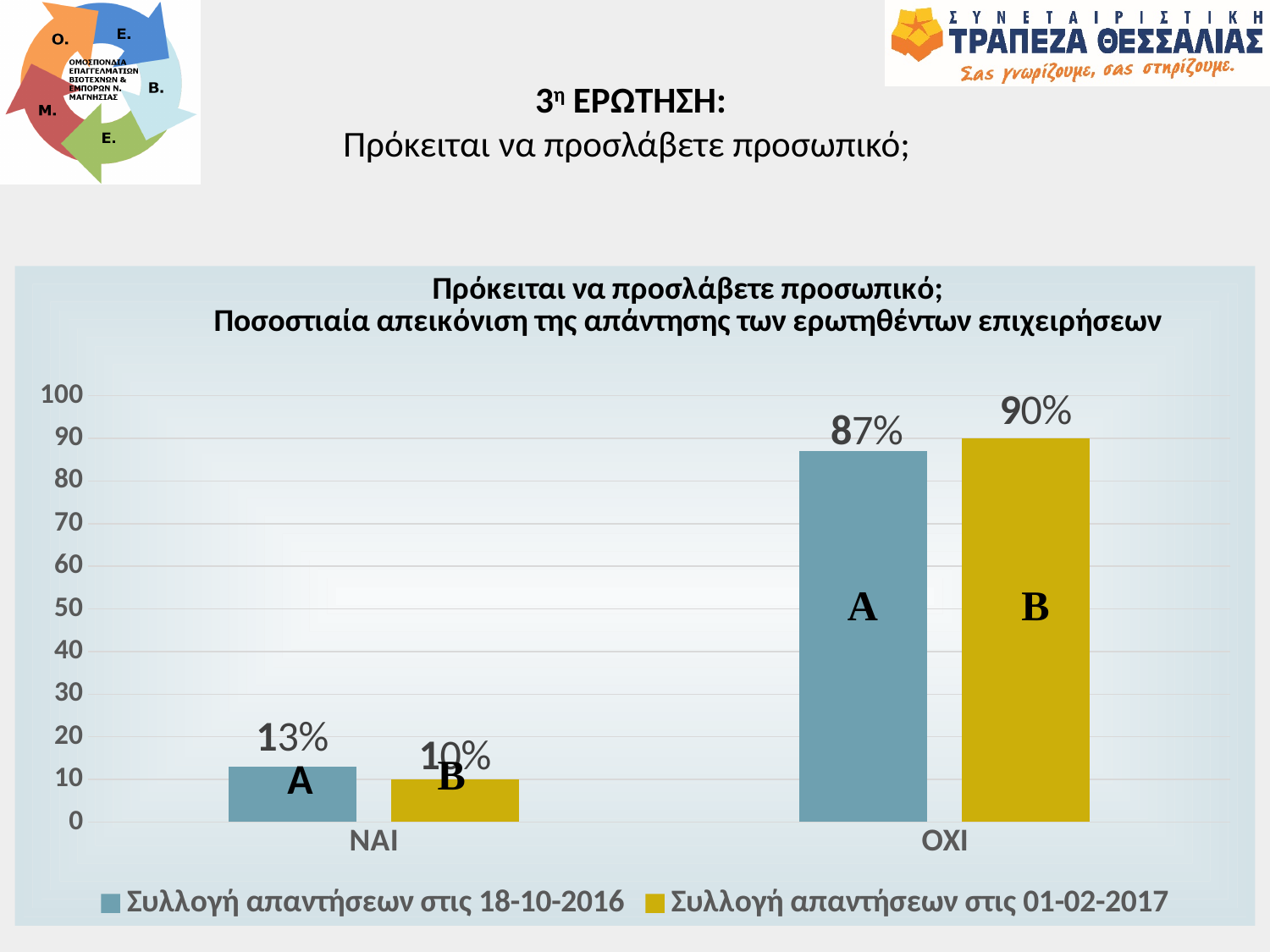
For ΝΑΙ, which series has the larger value: 18-10-2016 or 01-02-2017? 18-10-2016 Which category has the highest value in the 01-02-2017 series? ΟΧΙ How many categories are shown on the x axis? 2 What percentage of businesses answered ΟΧΙ in the 01-02-2017 collection (Συλλογή απαντήσεων στις 01-02-2017)? 90% What colour are the bars for the 01-02-2017 series (Συλλογή απαντήσεων στις 01-02-2017)? Yellow What is the value for ΝΑΙ in the 01-02-2017 series? 10% How many series does the legend list? 2 What is the value for ΟΧΙ in the 18-10-2016 series? 87% What is the difference between the ΟΧΙ values of the 01-02-2017 and 18-10-2016 series? 3% What percentage of businesses answered ΝΑΙ in the 18-10-2016 collection (Συλλογή απαντήσεων στις 18-10-2016)? 13% What kind of chart is shown on the slide? Bar chart Which category has the lowest value in the 18-10-2016 series? ΝΑΙ